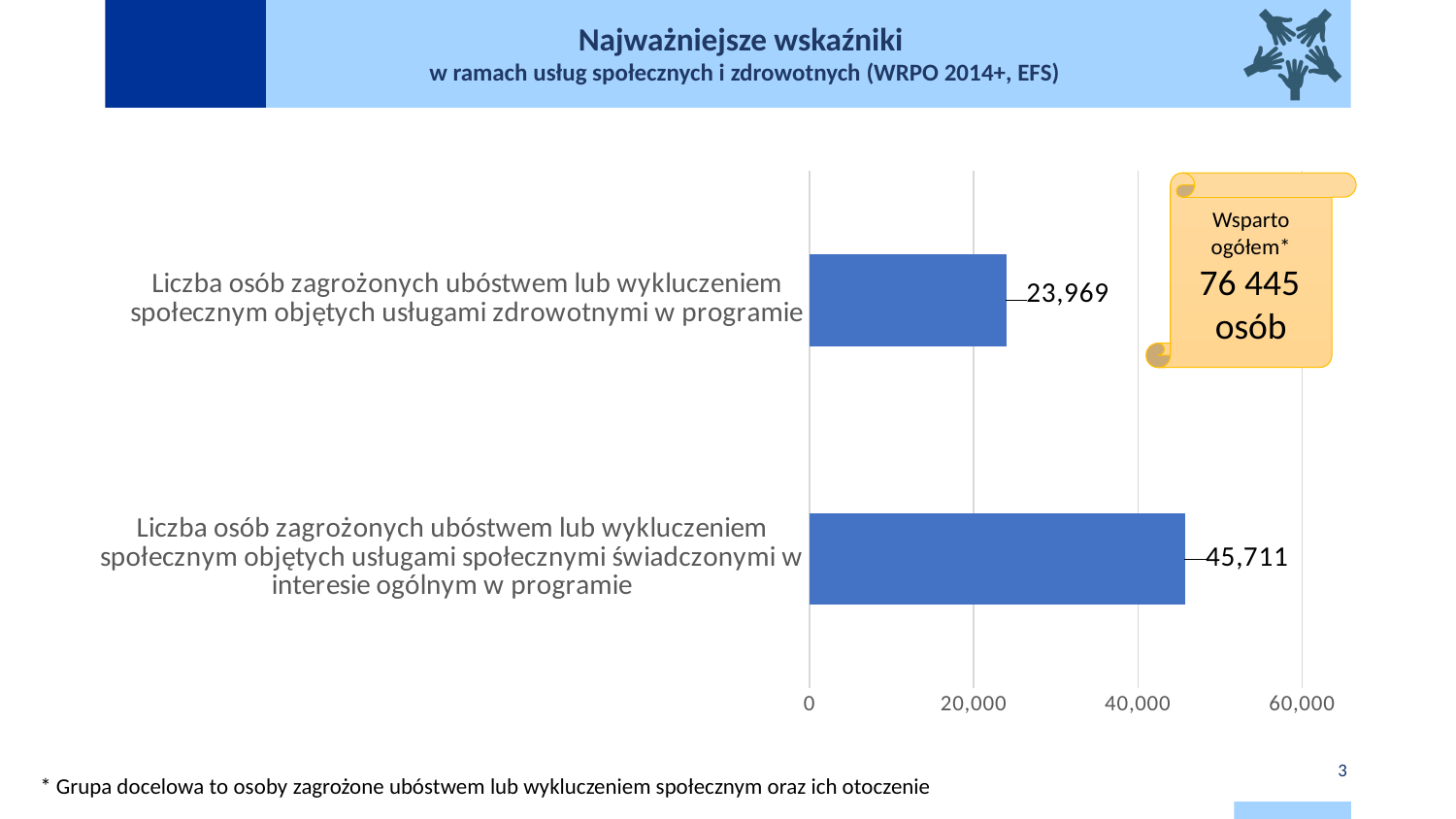
Is the value for people covered by social services (usługami społecznymi) greater or less than 60,000? less Is the value for people covered by health services (usługami zdrowotnymi) greater or less than 20,000? greater Which is larger: the value for people covered by health services (usługami zdrowotnymi) or the value for people covered by social services (usługami społecznymi)? usługami społecznymi (45,711) Which category has the highest value? Liczba osób zagrożonych ubóstwem lub wykluczeniem społecznym objętych usługami społecznymi świadczonymi w interesie ogólnym w programie What is the value for "Liczba osób zagrożonych ubóstwem lub wykluczeniem społecznym objętych usługami społecznymi świadczonymi w interesie ogólnym w programie"? 45,711 Which category has the lowest value? Liczba osób zagrożonych ubóstwem lub wykluczeniem społecznym objętych usługami zdrowotnymi w programie According to the callout next to the chart, how many people were supported in total (Wsparto ogółem)? 76 445 osób What is the difference between the value for people covered by social services (usługami społecznymi) and the value for people covered by health services (usługami zdrowotnymi)? 21,742 What is the highest value shown on the x axis of the chart? 60,000 What is the value for "Liczba osób zagrożonych ubóstwem lub wykluczeniem społecznym objętych usługami zdrowotnymi w programie"? 23,969 What kind of chart is shown on the slide? bar chart How many categories are shown in the chart? 2